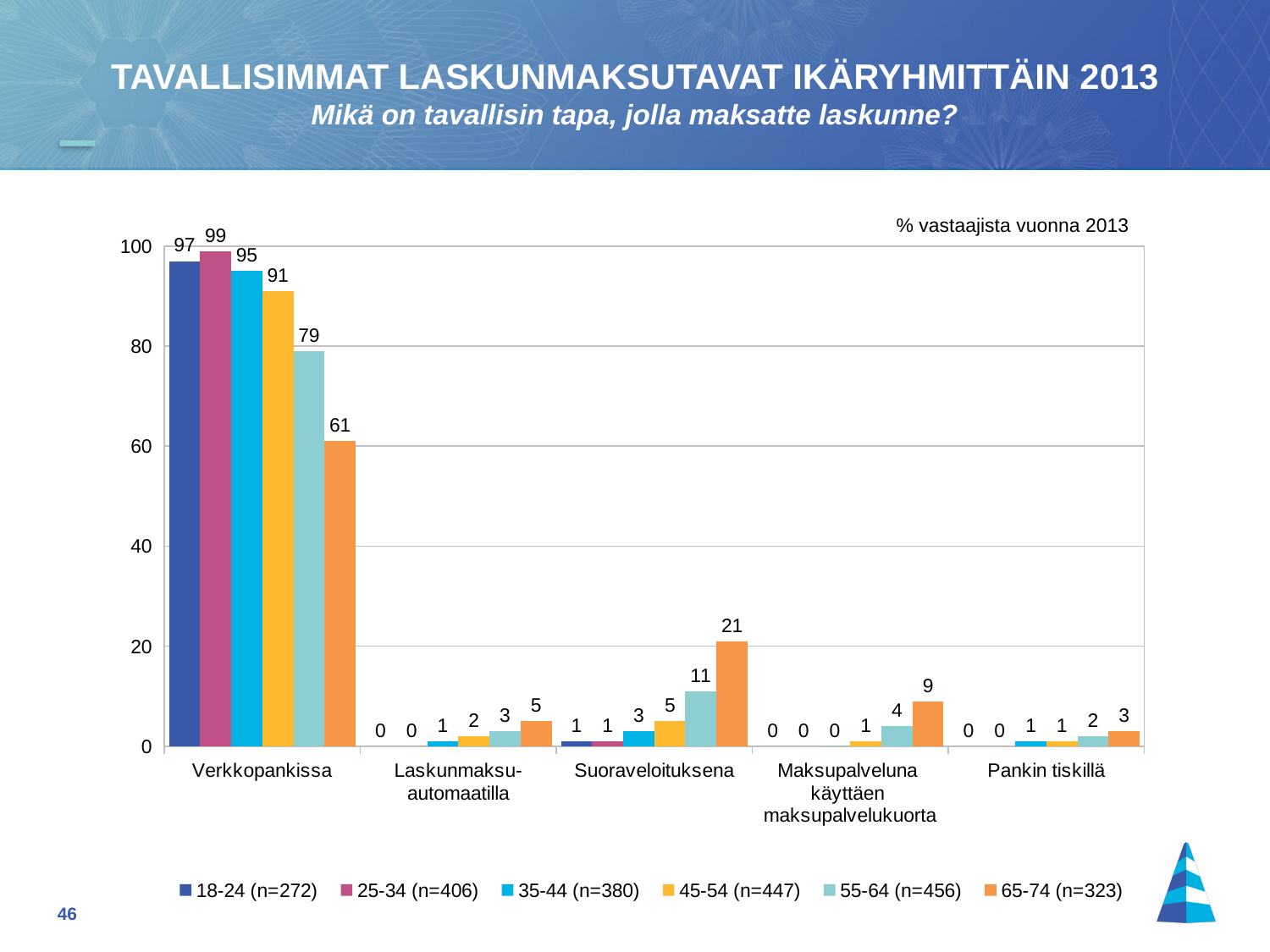
How many age-group series does the legend list? 6 How many payment-method categories are shown on the x axis? 5 What is the value for the 45-54 (n=447) age group in the Verkkopankissa category? 91 Is the value for the 55-64 (n=456) age group in the Verkkopankissa category greater or less than 80? less What kind of chart is shown on the slide? Bar chart What is the value for the 55-64 (n=456) age group in the Suoraveloituksena category? 11 Which age group has the highest value in the Verkkopankissa category? 25-34 (n=406) What is the difference between the 18-24 (n=272) and 65-74 (n=323) values in the Verkkopankissa category? 36 In the Suoraveloituksena category, which is larger: the value for 55-64 (n=456) or the value for 65-74 (n=323)? 65-74 (n=323) What is the value for the 65-74 (n=323) age group in the Verkkopankissa category? 61 What is the value for the 65-74 (n=323) age group in the Maksupalveluna käyttäen maksupalvelukuorta category? 9 Which age group has the lowest value in the Verkkopankissa category? 65-74 (n=323)